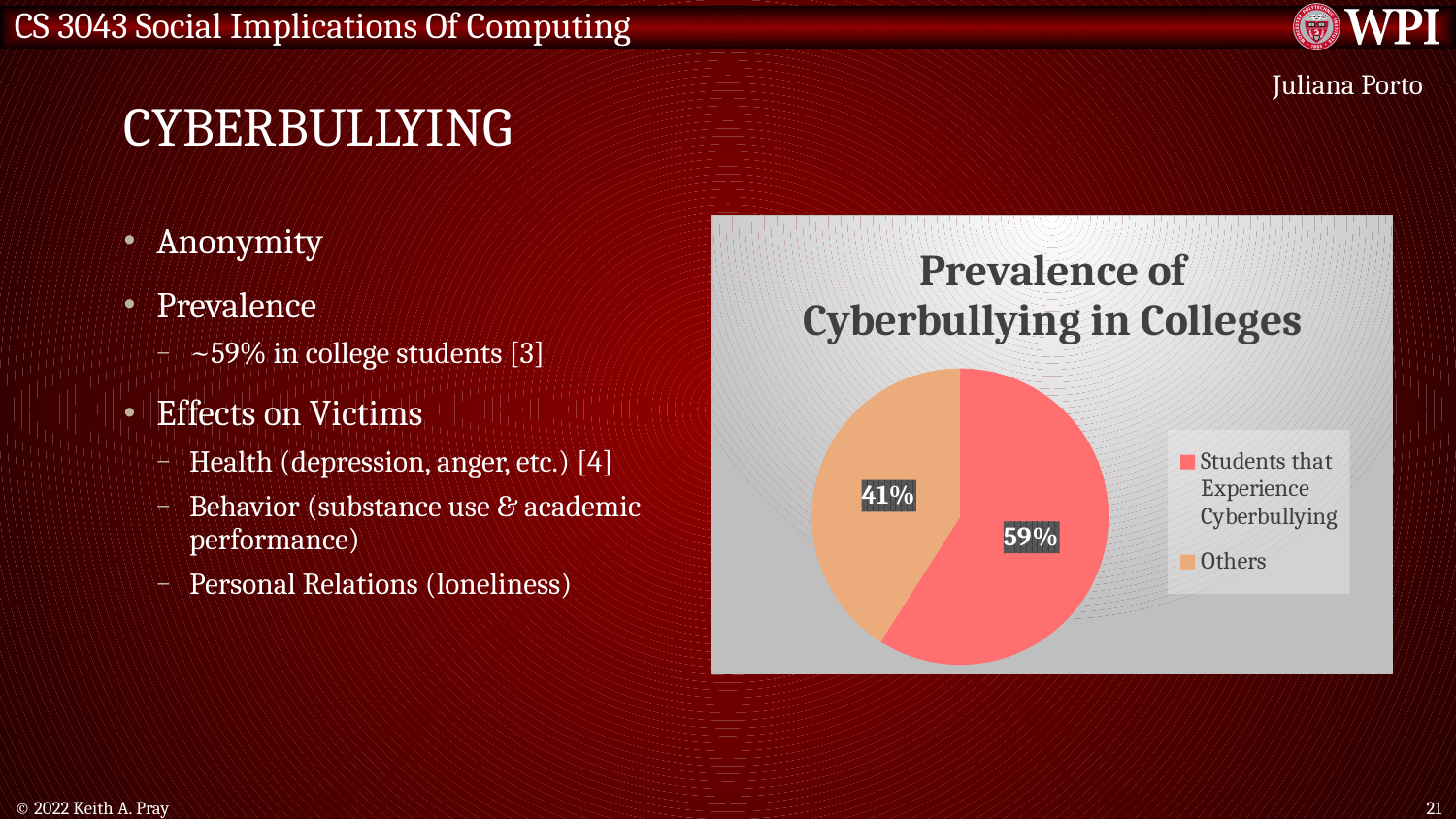
What is the title of the chart? Prevalence of Cyberbullying in Colleges What percentage of the pie is labelled for Students that Experience Cyberbullying? 59% What colour is the Others slice in the pie chart? orange What share of the pie does the Others slice represent? 41% Which slice of the pie is the smallest? Others What percentage of the pie is labelled for Others? 41% How many slices does the pie chart have? 2 Which slice of the pie is the largest? Students that Experience Cyberbullying What type of chart is shown on the slide? pie chart How many entries does the legend list? 2 What is the difference in percentage points between the Students that Experience Cyberbullying slice and the Others slice? 18 Which is larger, the Others slice or the Students that Experience Cyberbullying slice? Students that Experience Cyberbullying